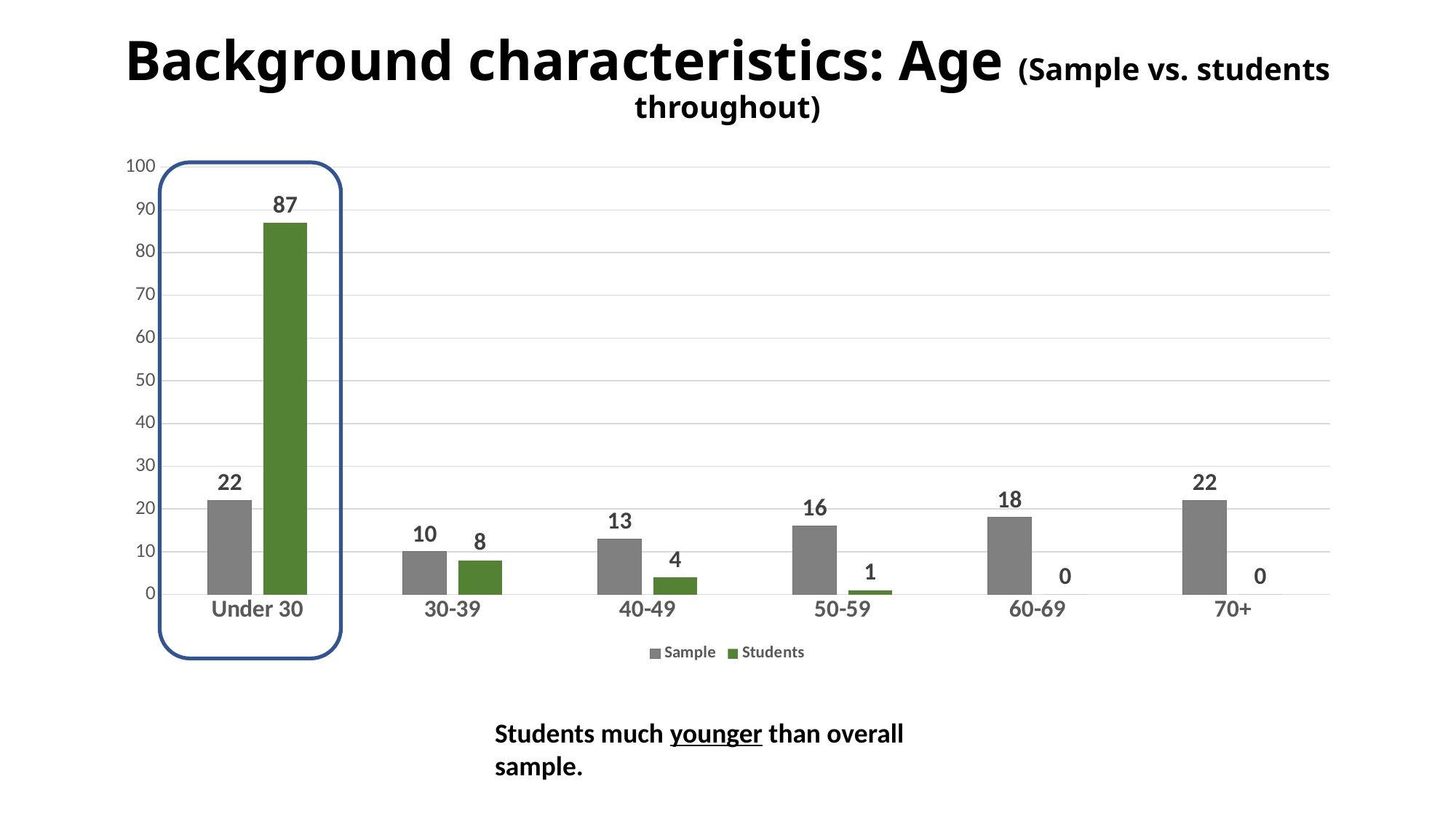
What is the Students value for the Under 30 age group? 87 What is the Sample value for the 50-59 age group? 16 What kind of chart is shown on the slide? Bar chart Which is larger for the 30-39 age group, the Sample value or the Students value? Sample Which age group has the highest Sample value? Under 30 and 70+ (both 22) How many series does the legend list? 2 Which age group has the lowest Sample value? 30-39 What is the difference between the Students and Sample values for the Under 30 age group? 65 What is the Students value for the 40-49 age group? 4 Do the Students values rise or fall from Under 30 to 70+? Fall How many age groups are shown on the x axis? 6 Which colour represents the Students series? Green